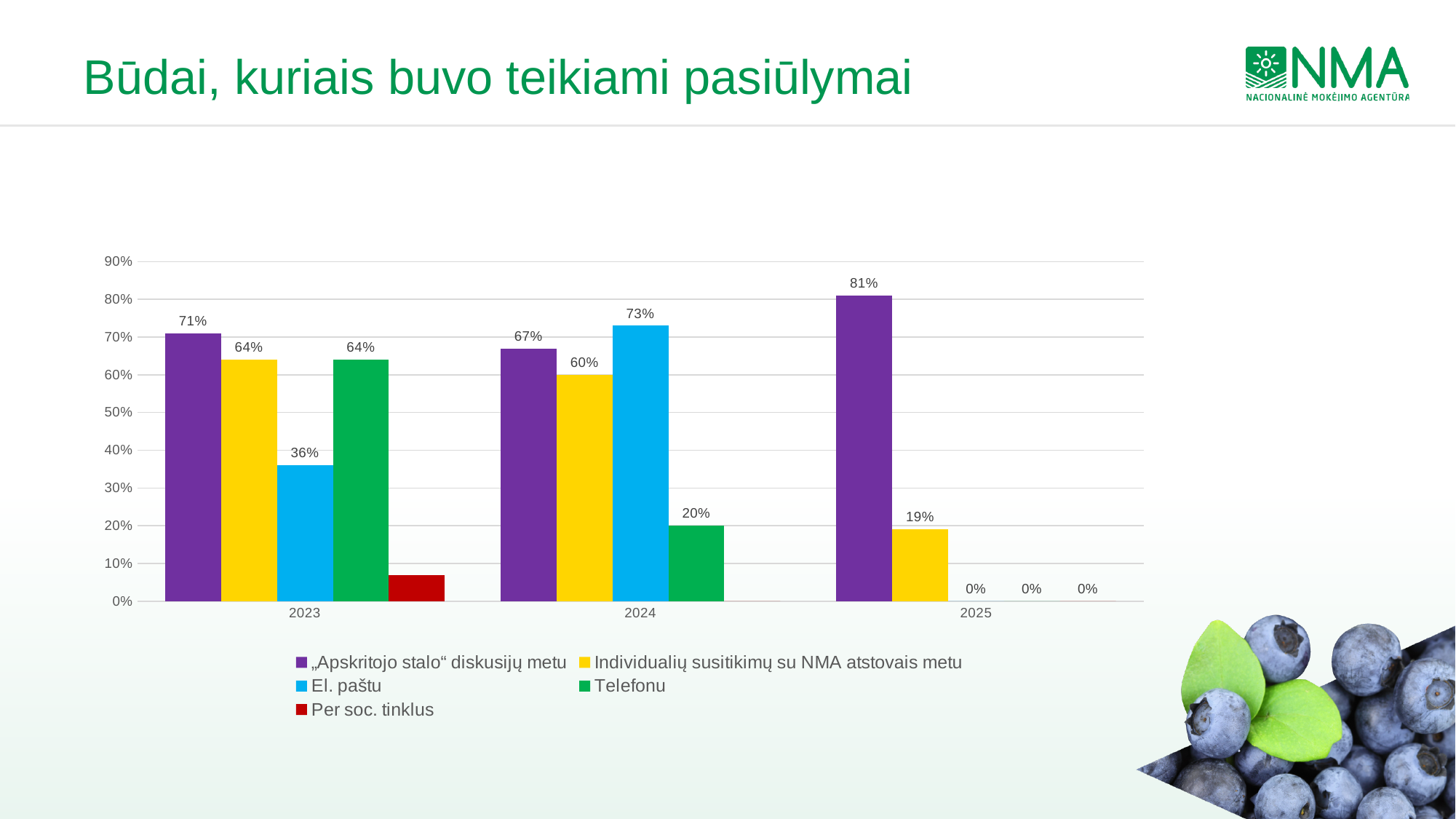
Which is larger in 2024: Individualių susitikimų su NMA atstovais metu or Telefonu? Individualių susitikimų su NMA atstovais metu What kind of chart is shown on the slide? bar chart What is the value for „Apskritojo stalo“ diskusijų metu in 2025? 81% What is the difference between the „Apskritojo stalo“ diskusijų metu values for 2025 and 2023? 10% Is the value for Per soc. tinklus in 2023 greater or less than 10%? less How many series does the legend list? 5 Which series has the lowest labelled value in 2023? El. paštu How many year categories are shown on the x axis? 3 What is the value for Telefonu in 2023? 64% Which series has the highest value in 2024? El. paštu How does the value for Telefonu change from 2023 to 2025? It falls What is the value for El. paštu in 2024? 73%